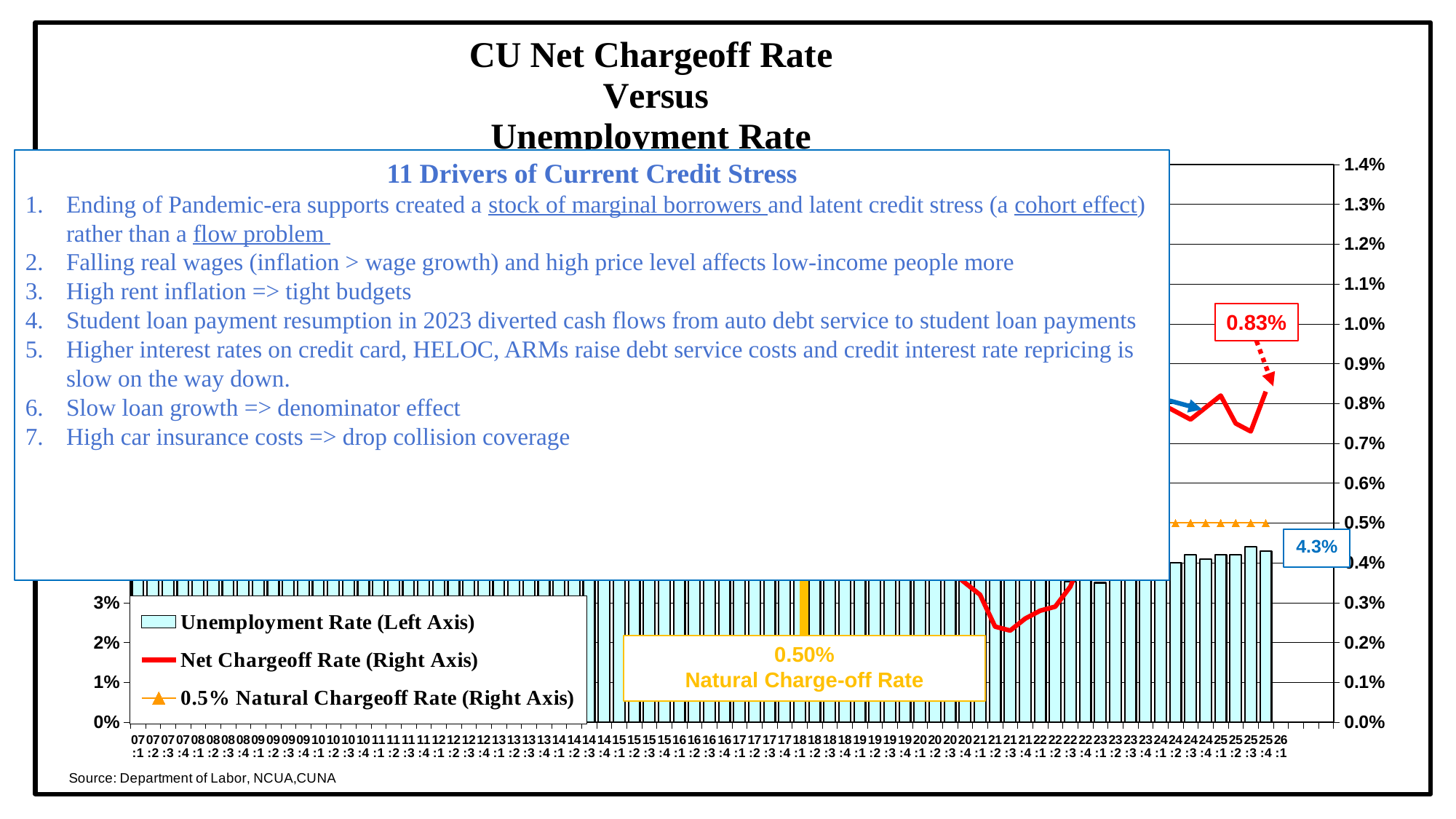
What projected value is labeled for the Net Chargeoff Rate at the end of the series? 0.83% What kind of chart is shown on the slide? A combined bar and line chart What is the Natural Charge-off Rate shown on the chart? 0.50% Is the Net Chargeoff Rate at its 2021 low point greater or less than 0.5%? less How many series does the chart legend list? 3 What is the difference between the labeled 0.83% Net Chargeoff Rate and the 0.50% Natural Charge-off Rate? 0.33% What is the highest value shown on the right-hand axis? 1.4% What value is labeled for the Unemployment Rate at the end of the series? 4.3% Which series is plotted on the left axis according to the legend? Unemployment Rate (Left Axis) From its low in 2021 through 2022, does the Net Chargeoff Rate rise or fall? rise Which is larger, the labeled projected Net Chargeoff Rate or the Natural Charge-off Rate? Net Chargeoff Rate (0.83%) Is the Unemployment Rate in 2025 greater or less than 3%? greater